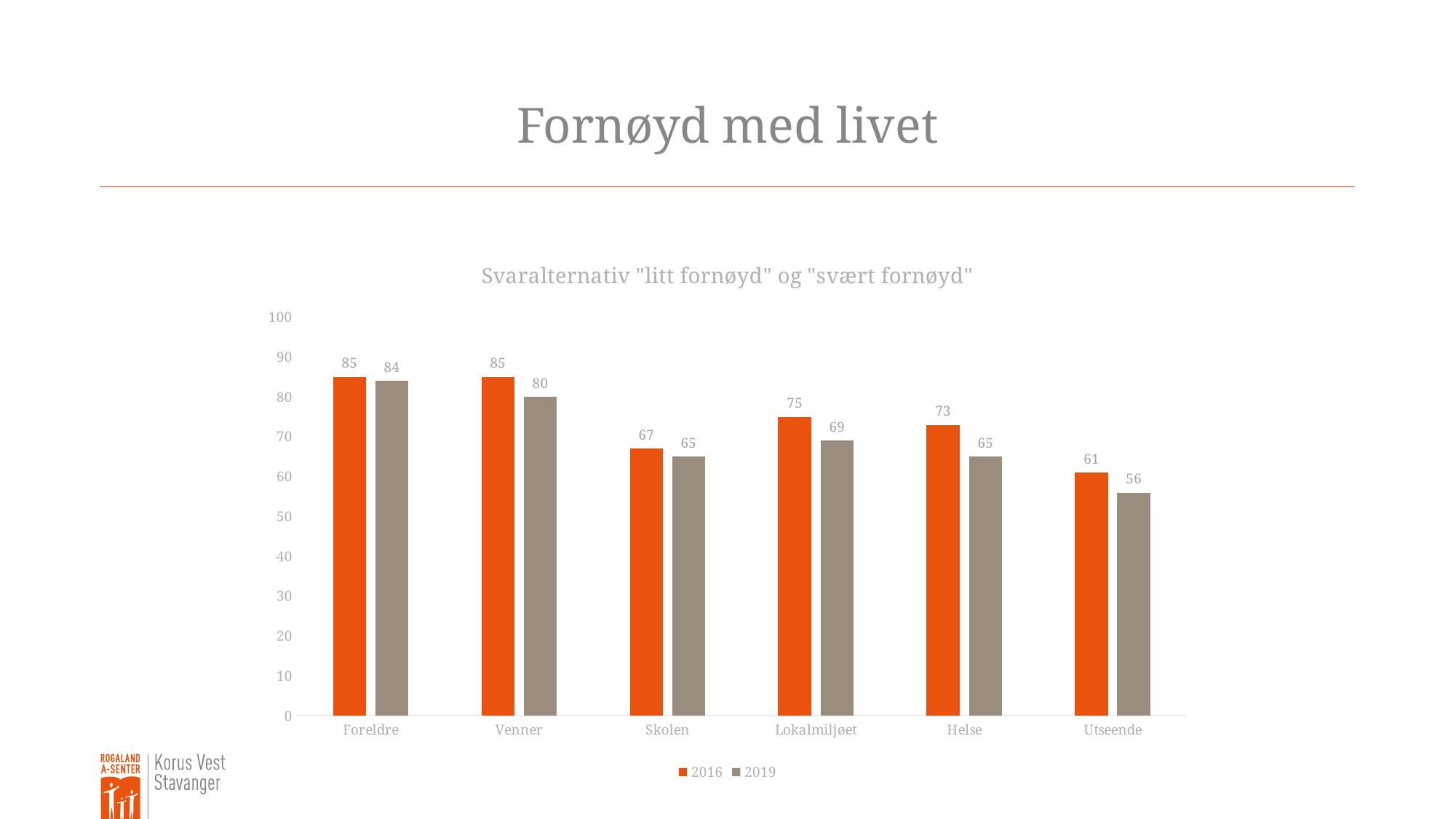
What kind of chart is shown on the slide? Bar chart What is the title of the chart? Svaralternativ "litt fornøyd" og "svært fornøyd" What is the difference between the 2016 and 2019 values for Venner? 5 How many series does the legend list? 2 What is the value for Lokalmiljøet in 2019? 69 Which category has the lowest value in 2016? Utseende Which category has the lowest value in 2019? Utseende Which is larger, the 2016 value for Skolen or the 2016 value for Helse? Helse How many categories are shown on the x axis? 6 What is the value for Utseende in 2019? 56 What is the value for Foreldre in 2016? 85 What is the difference between the 2016 and 2019 values for Helse? 8